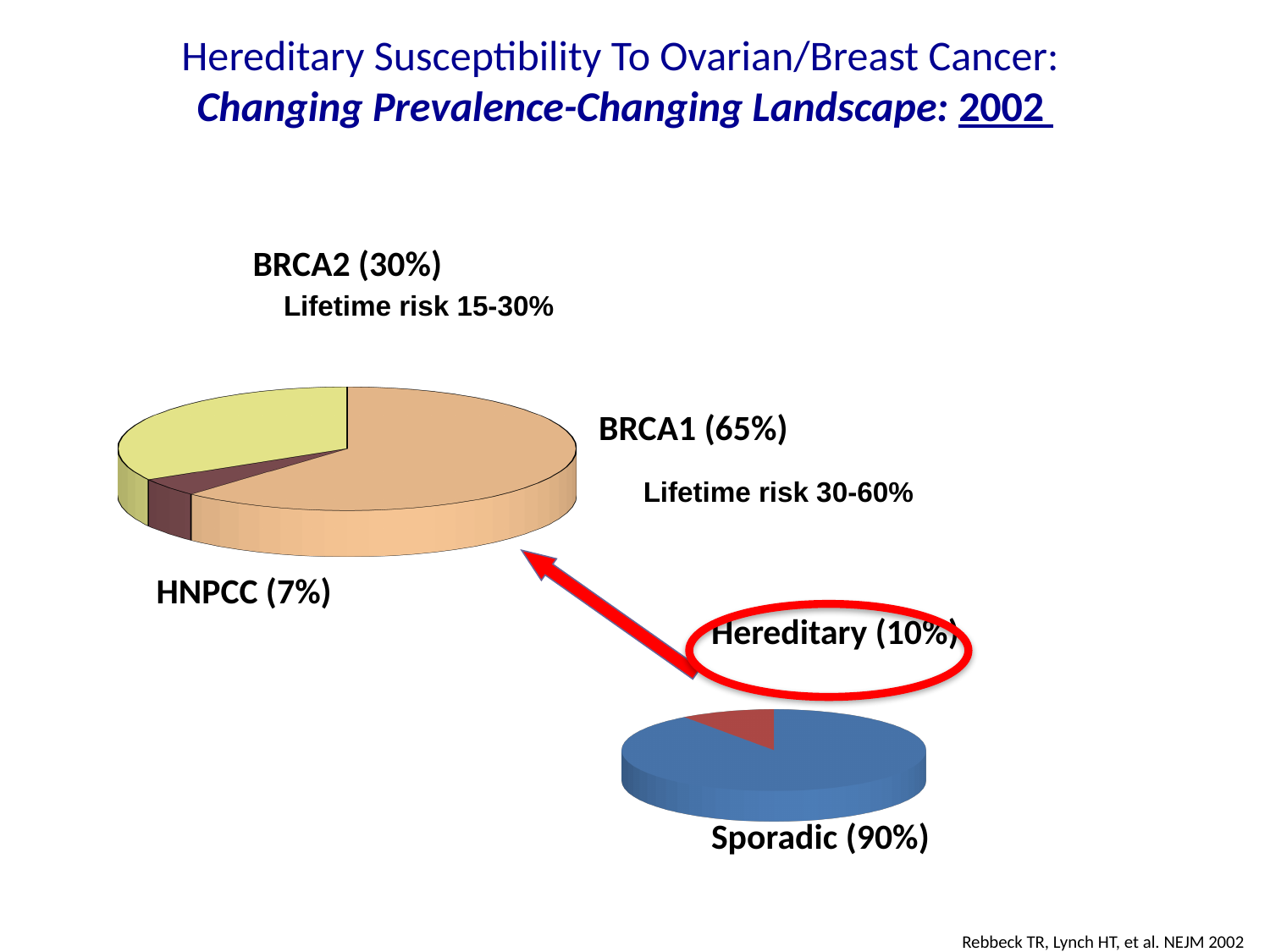
How many slices does the upper-left pie chart have? 3 In the upper-left pie chart, what is the difference in percentage points between BRCA1 and BRCA2? 35 In the upper-left pie chart, what percentage is given for BRCA2? 30% In the lower-right pie chart, what share is labelled Sporadic? 90% In the upper-left pie chart, what percentage is given for BRCA1? 65% In the upper-left pie chart, what percentage is given for HNPCC? 7% In the lower-right pie chart, what share is labelled Hereditary? 10% In the upper-left pie chart, which category has the smallest share? HNPCC What kind of charts are shown on the slide? Pie charts In the lower-right pie chart, which is larger, Sporadic or Hereditary? Sporadic What lifetime risk range is shown next to BRCA1 on the slide? 30-60% In the upper-left pie chart, which category has the largest share? BRCA1